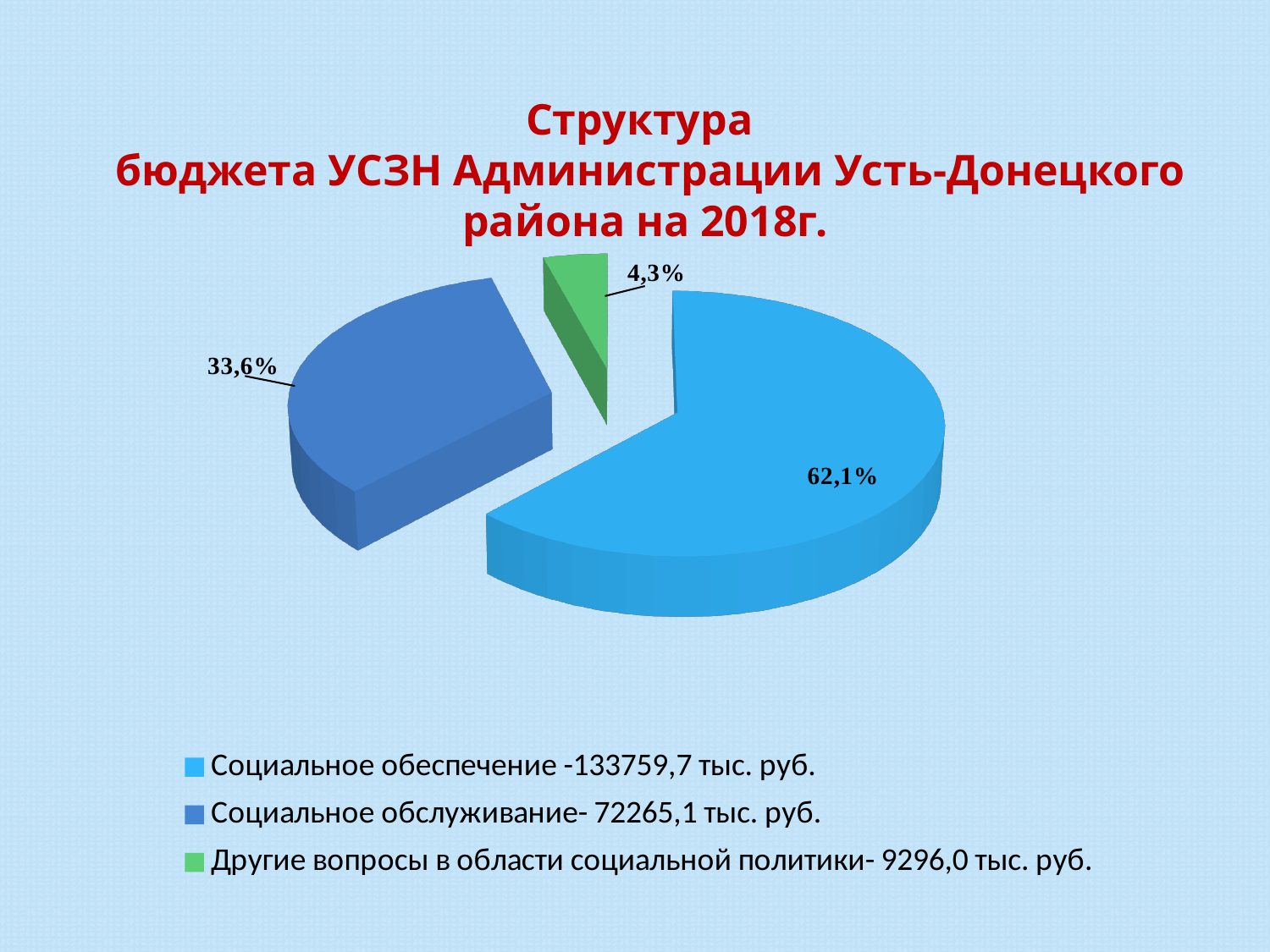
Which category has the smallest slice of the pie? Другие вопросы в области социальной политики According to the legend, what amount in тыс. руб. corresponds to Социальное обеспечение? 133759,7 тыс. руб. What share of the pie does Социальное обслуживание have? 33,6% How many slices does the pie chart have? 3 What share of the pie does Другие вопросы в области социальной политики have? 4,3% According to the legend, what amount in тыс. руб. corresponds to Другие вопросы в области социальной политики? 9296,0 тыс. руб. What is the difference in percentage points between the shares of Социальное обеспечение and Социальное обслуживание? 28,5 What colour is the slice for Другие вопросы в области социальной политики? Green Which category has the largest slice of the pie? Социальное обеспечение What share of the pie does Социальное обеспечение have? 62,1% What kind of chart is shown on the slide? Pie chart Which is larger: the share of Социальное обслуживание or the share of Другие вопросы в области социальной политики? Социальное обслуживание